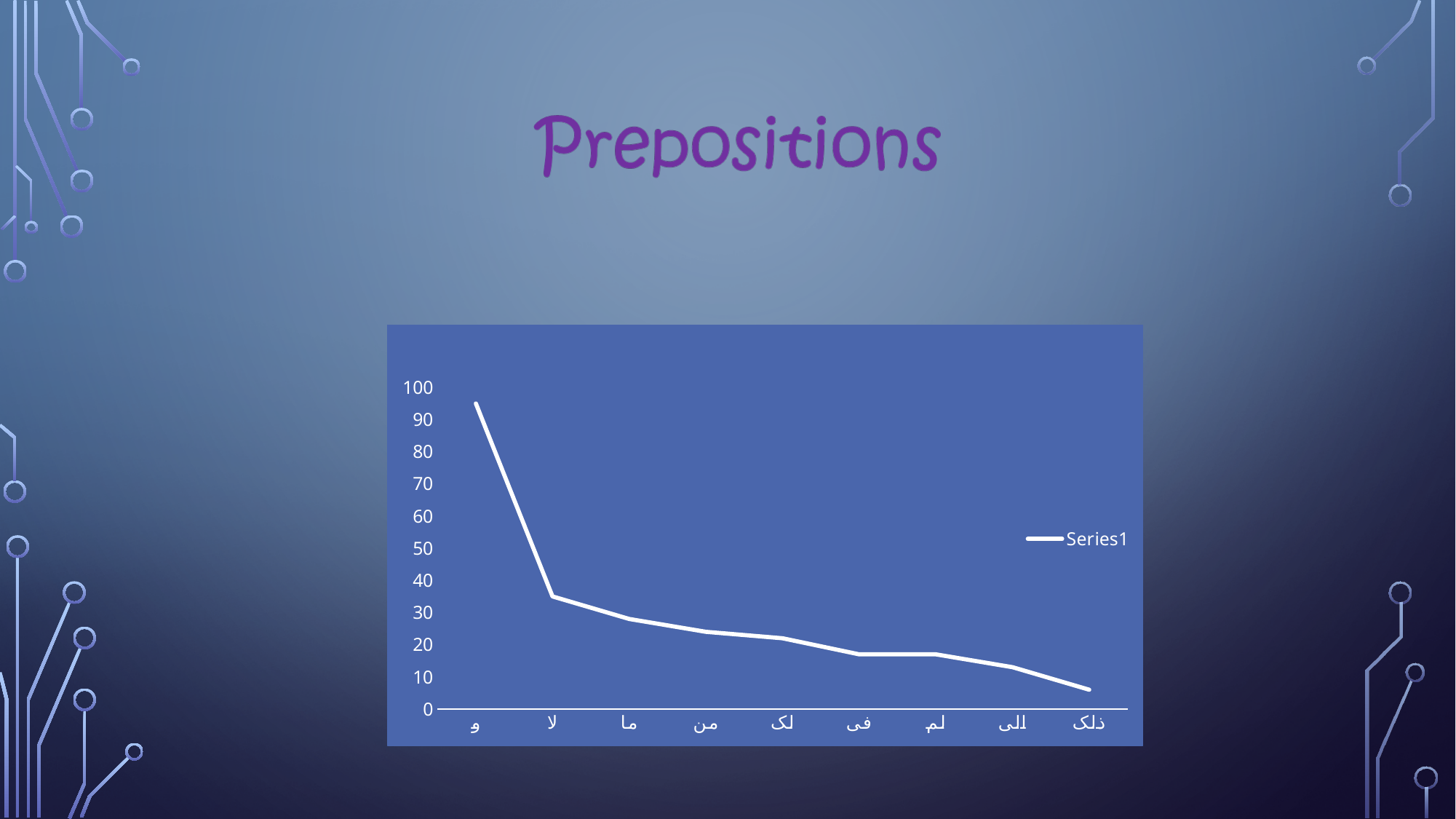
Which category has the lowest value? ذلک What kind of chart is shown on the slide? line chart Is the value for ذلك greater or less than 10? less Is the value for لا greater or less than 40? less What is the name of the series shown in the legend? Series1 How many categories are plotted along the x axis? 9 Which has the larger value, لا or الى? لا Which category has the highest value? و How many series does the legend list? 1 Is the value for و greater or less than 90? greater What is the title of the slide containing the chart? Prepositions Do the values rise or fall moving from left to right along the x axis? fall